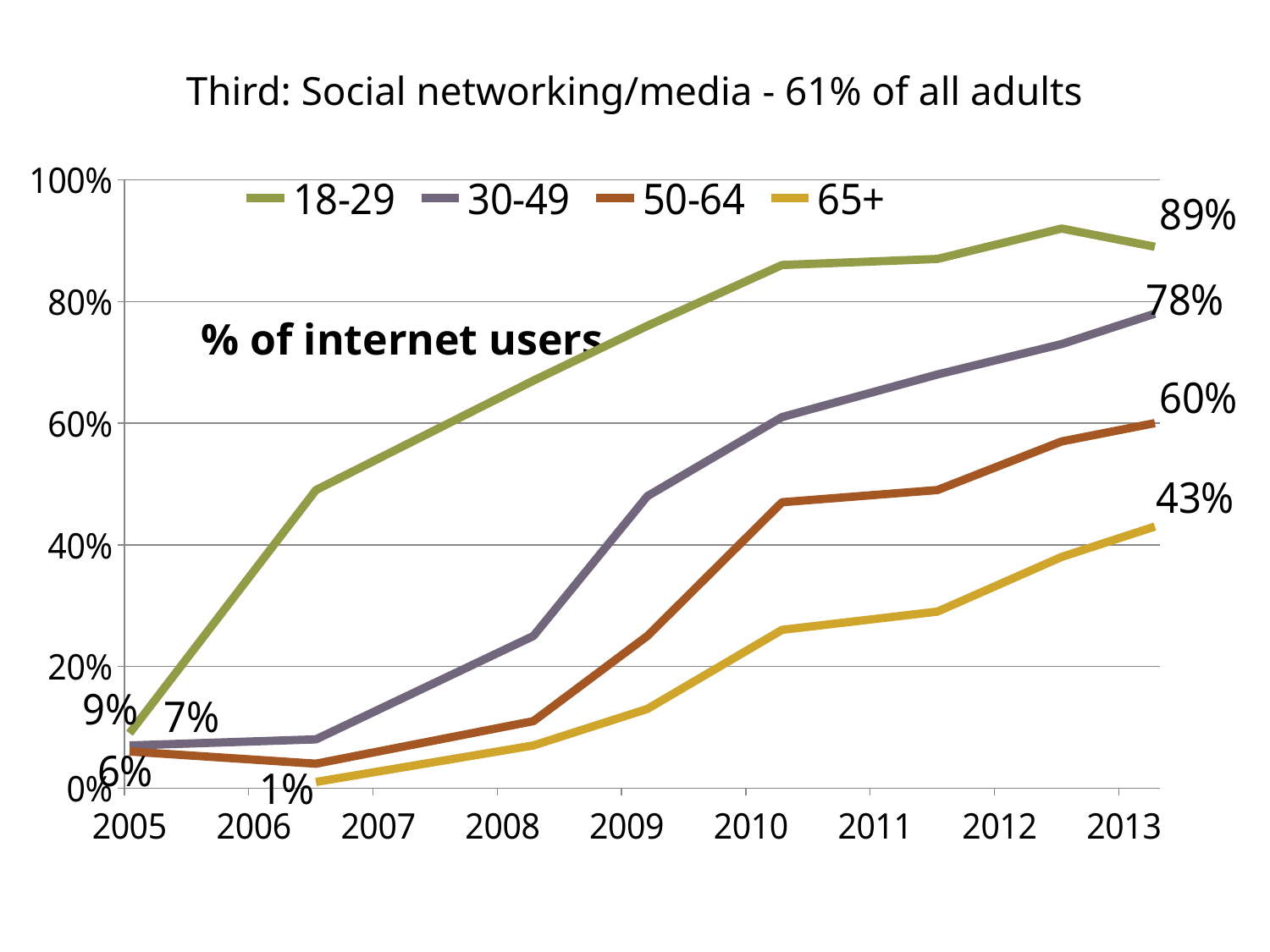
How many series does the legend list? 4 Does the 65+ series rise or fall from 2007 to 2013? rise What is the final (2013) value for the 18-29 series? 89% What is the final (2013) value for the 50-64 series? 60% What is the final (2013) value for the 65+ series? 43% Which age group has the lowest value at the end of the chart in 2013? 65+ What is the final (2013) value for the 30-49 series? 78% Which age group has the highest value at the end of the chart in 2013? 18-29 What type of chart is shown on the slide? line chart What is the difference between the 2013 values of the 18-29 and 65+ series? 46% What is the title of the chart? Third: Social networking/media - 61% of all adults